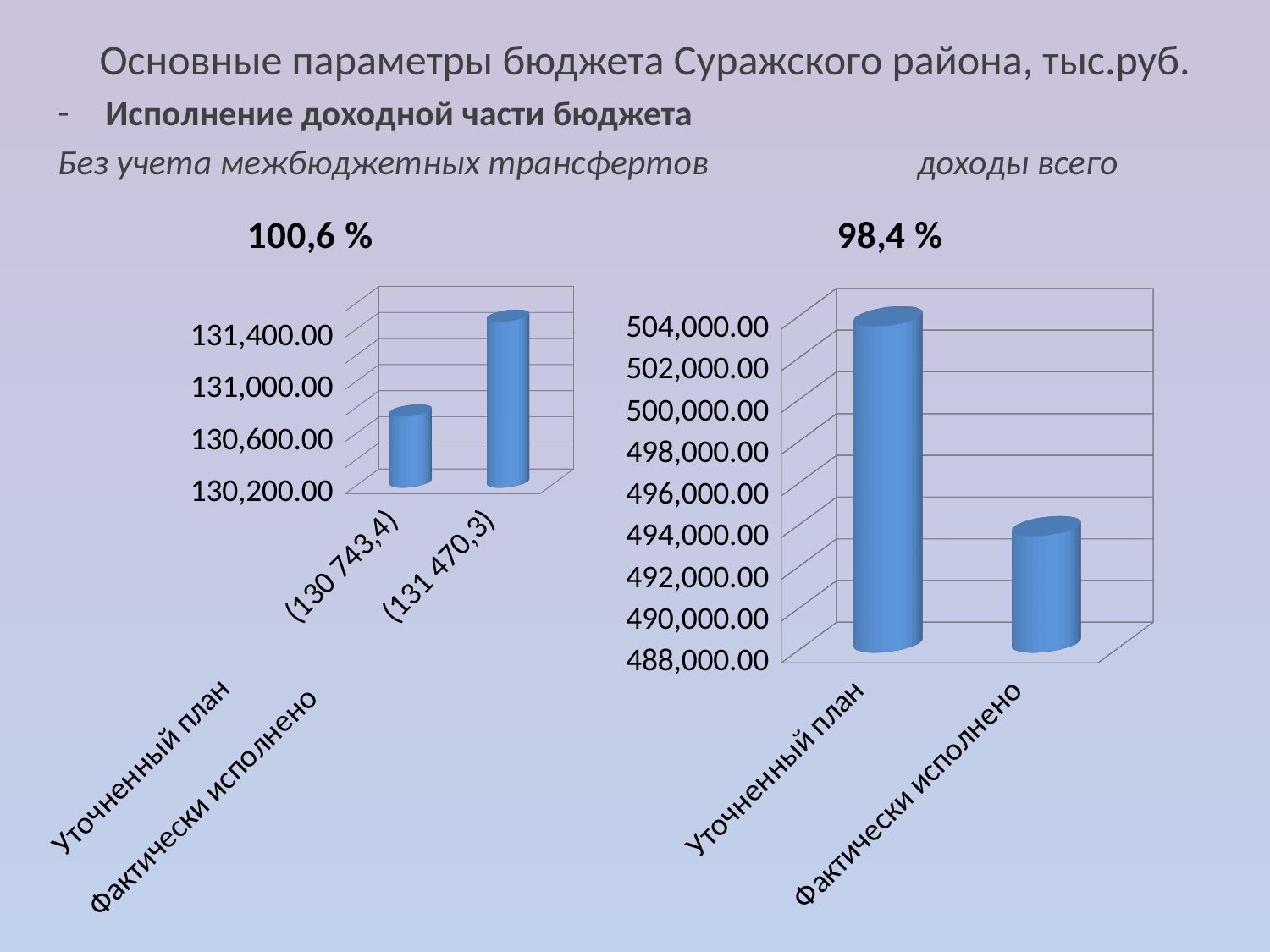
In the right chart (доходы всего), is the value for Уточненный план greater or less than 500,000.00? greater In the left chart (Без учета межбюджетных трансфертов), which category has the higher value? Фактически исполнено In the right chart (доходы всего), which is larger: Уточненный план or Фактически исполнено? Уточненный план In the right chart (доходы всего), is the value for Фактически исполнено greater or less than 496,000.00? less In the left chart (Без учета межбюджетных трансфертов), what is the difference between Фактически исполнено and Уточненный план? 726,9 In the left chart (Без учета межбюджетных трансфертов), which category has the lower value? Уточненный план How many categories does the right chart (доходы всего) show? 2 What type of chart is the left chart (Без учета межбюджетных трансфертов)? Bar chart What execution percentage is shown above the right chart (доходы всего)? 98,4 % In the left chart (Без учета межбюджетных трансфертов), what value is shown for Уточненный план? 130 743,4 In the left chart (Без учета межбюджетных трансфертов), what value is shown for Фактически исполнено? 131 470,3 What execution percentage is shown above the left chart (Без учета межбюджетных трансфертов)? 100,6 %